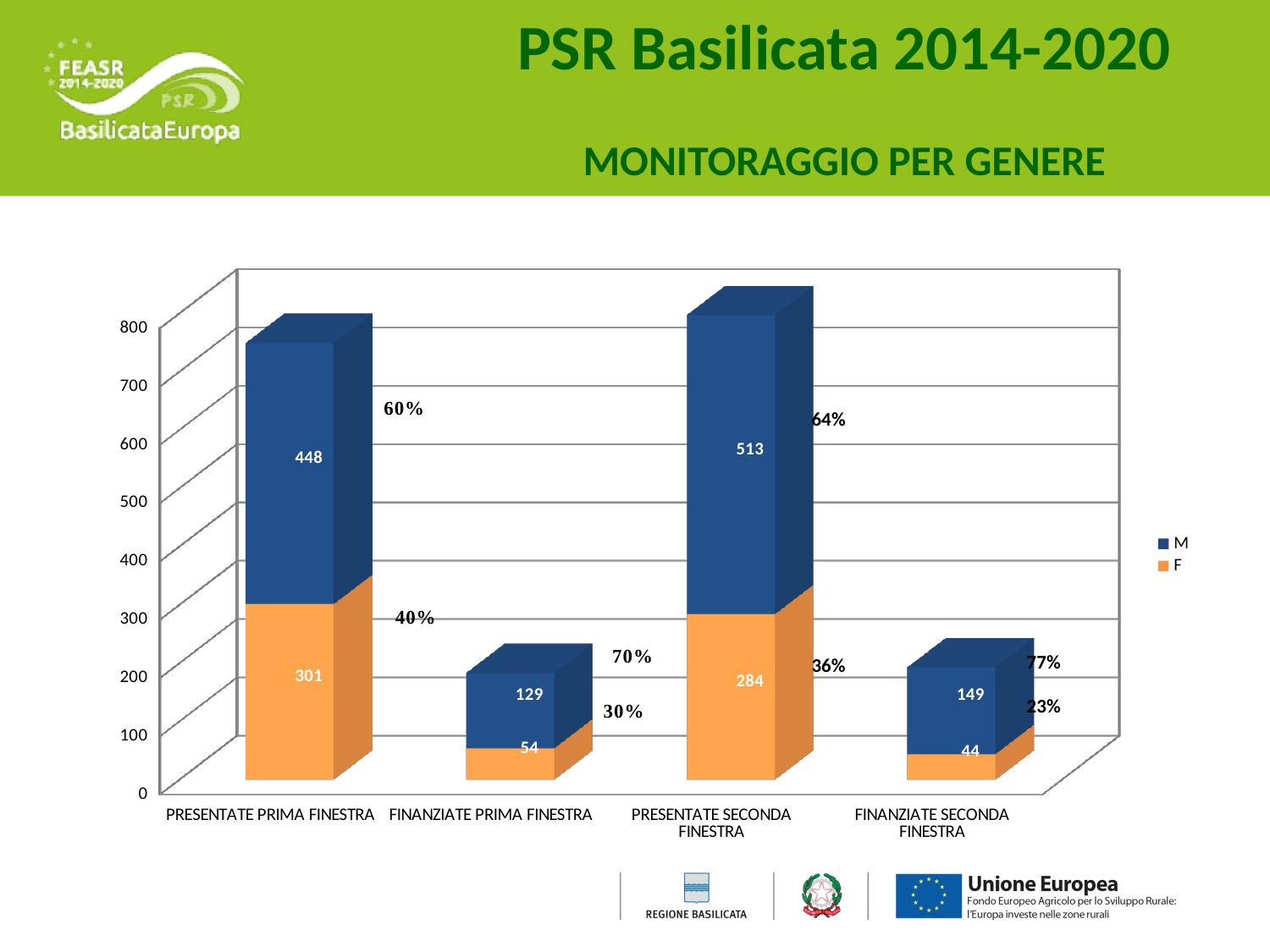
Which category has the highest value for M? PRESENTATE SECONDA FINESTRA What is the value for F in the FINANZIATE SECONDA FINESTRA bar? 44 What is the total of the stacked bar for PRESENTATE PRIMA FINESTRA? 749 What is the value for F in the PRESENTATE SECONDA FINESTRA bar? 284 How many series does the legend list? 2 What kind of chart is shown on the slide? Stacked bar chart What is the total of the stacked bar for FINANZIATE PRIMA FINESTRA? 183 How many categories are shown on the x axis? 4 What is the value for M in the PRESENTATE PRIMA FINESTRA bar? 448 Which is larger: the F value for PRESENTATE PRIMA FINESTRA or the F value for PRESENTATE SECONDA FINESTRA? PRESENTATE PRIMA FINESTRA What is the difference between the M values for PRESENTATE SECONDA FINESTRA and PRESENTATE PRIMA FINESTRA? 65 Which category has the lowest value for F? FINANZIATE SECONDA FINESTRA